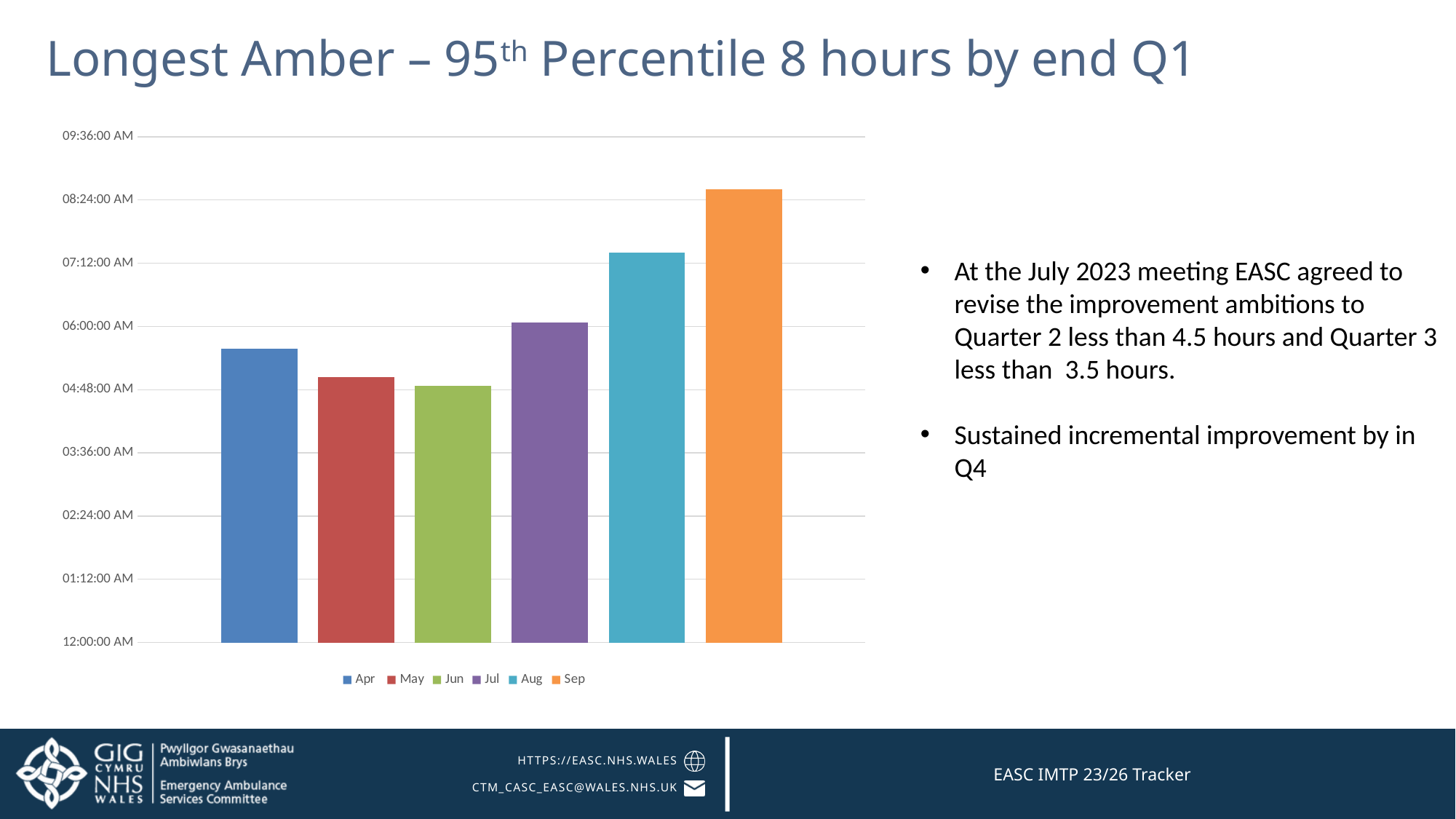
Which is larger, the value for Aug or the value for Jul? Aug Is the value for May greater or less than 06:00:00 AM? less How many bars are plotted in the chart? 6 Is the value for Sep greater or less than 08:24:00 AM? greater Is the value for Aug greater or less than 06:00:00 AM? greater What kind of chart is shown on the slide? bar chart Which is larger, the value for Apr or the value for May? Apr Which month has the highest bar in the chart? Sep From Jun to Sep, do the bar values rise or fall? rise How many entries does the chart legend list? 6